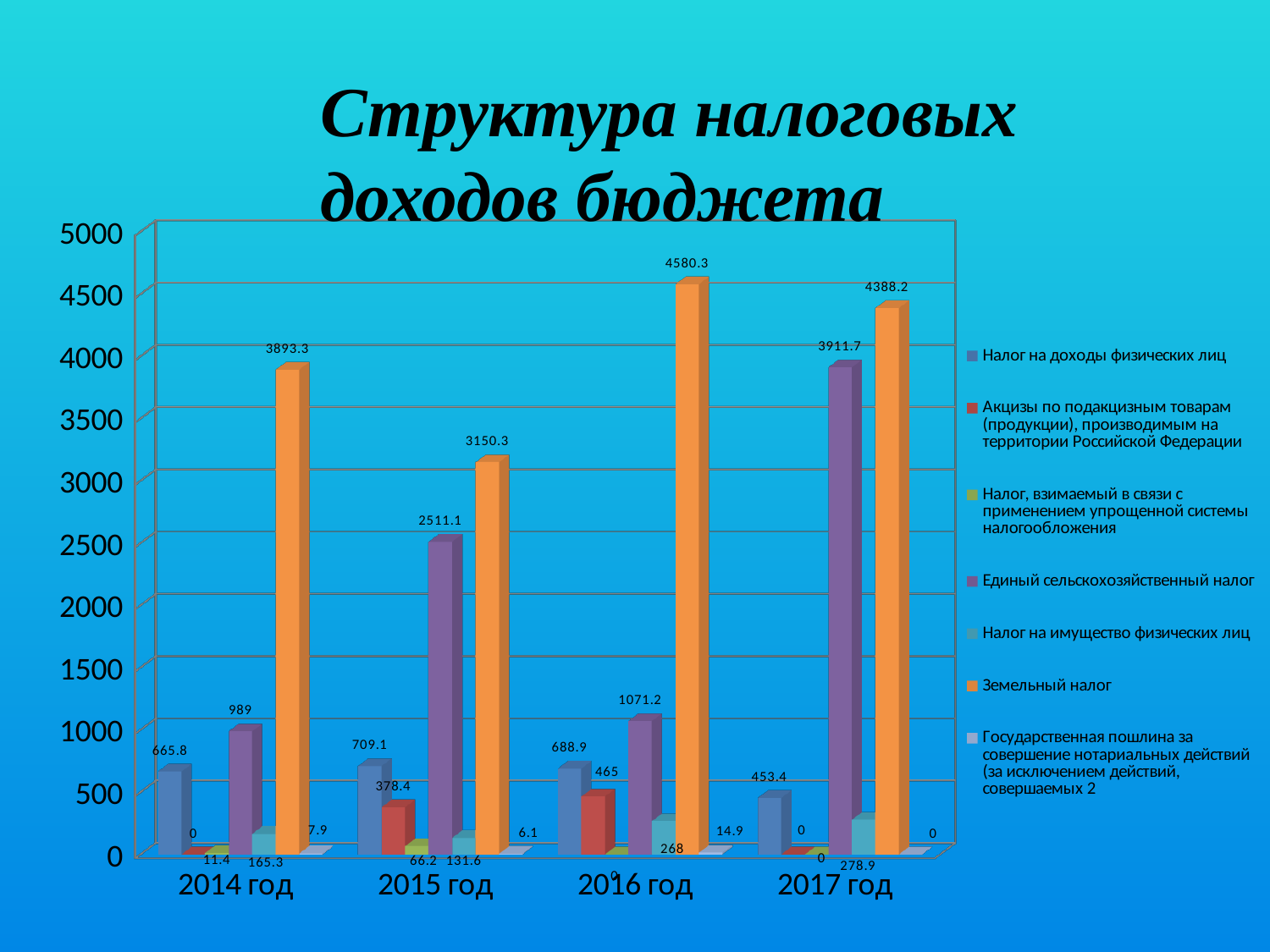
Which year has the larger value for Единый сельскохозяйственный налог, 2015 год or 2016 год? 2015 год In which year is Налог на доходы физических лиц the lowest? 2017 год What is the value of Единый сельскохозяйственный налог for 2017 год? 3911.7 What kind of chart is shown on the slide? bar chart What is the title of the chart? Структура налоговых доходов бюджета What is the value of Земельный налог for 2016 год? 4580.3 What is the value of Налог на доходы физических лиц for 2015 год? 709.1 What is the difference between Земельный налог in 2016 год and 2017 год? 192.1 How many series does the legend list? 7 How many year categories are shown on the x axis? 4 What is the value of Акцизы по подакцизным товарам for 2016 год? 465 In which year is Земельный налог the highest? 2016 год